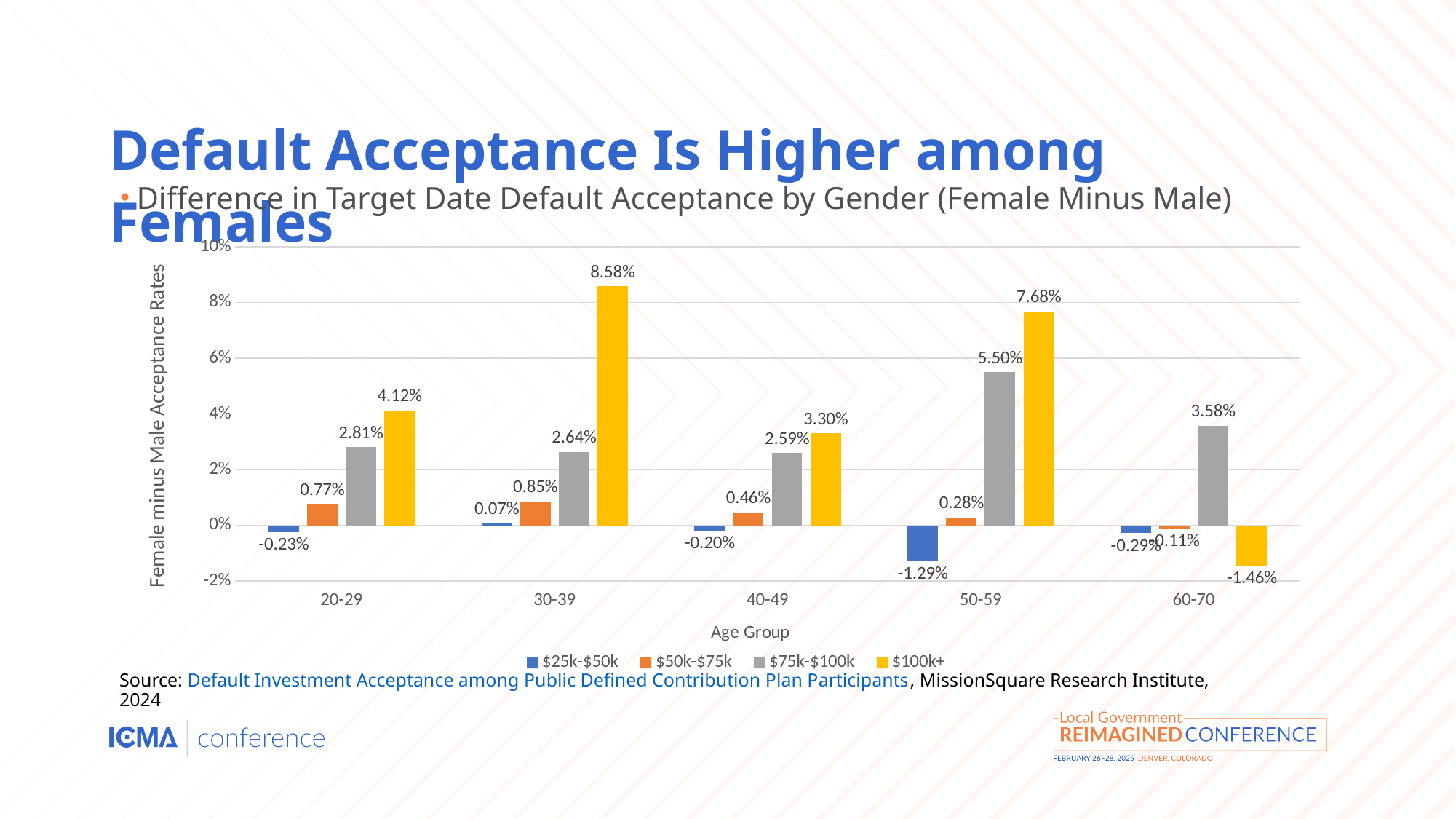
What is the value for the $100k+ series in the 30-39 age group? 8.58% Is the value for the $100k+ series in the 60-70 age group greater or less than 0%? less Which is larger for the $75k-$100k series: the 20-29 age group or the 30-39 age group? 20-29 What is the difference between the $100k+ and $75k-$100k values in the 20-29 age group? 1.31% Which age group has the highest value for the $100k+ series? 30-39 How many series does the legend list? 4 Which age group has the lowest value for the $25k-$50k series? 50-59 How many age groups are shown on the x axis? 5 What kind of chart is shown on the slide? bar chart What is the difference between the $100k+ values for the 30-39 and 50-59 age groups? 0.90% What is the value for the $25k-$50k series in the 50-59 age group? -1.29% What is the value for the $75k-$100k series in the 50-59 age group? 5.50%